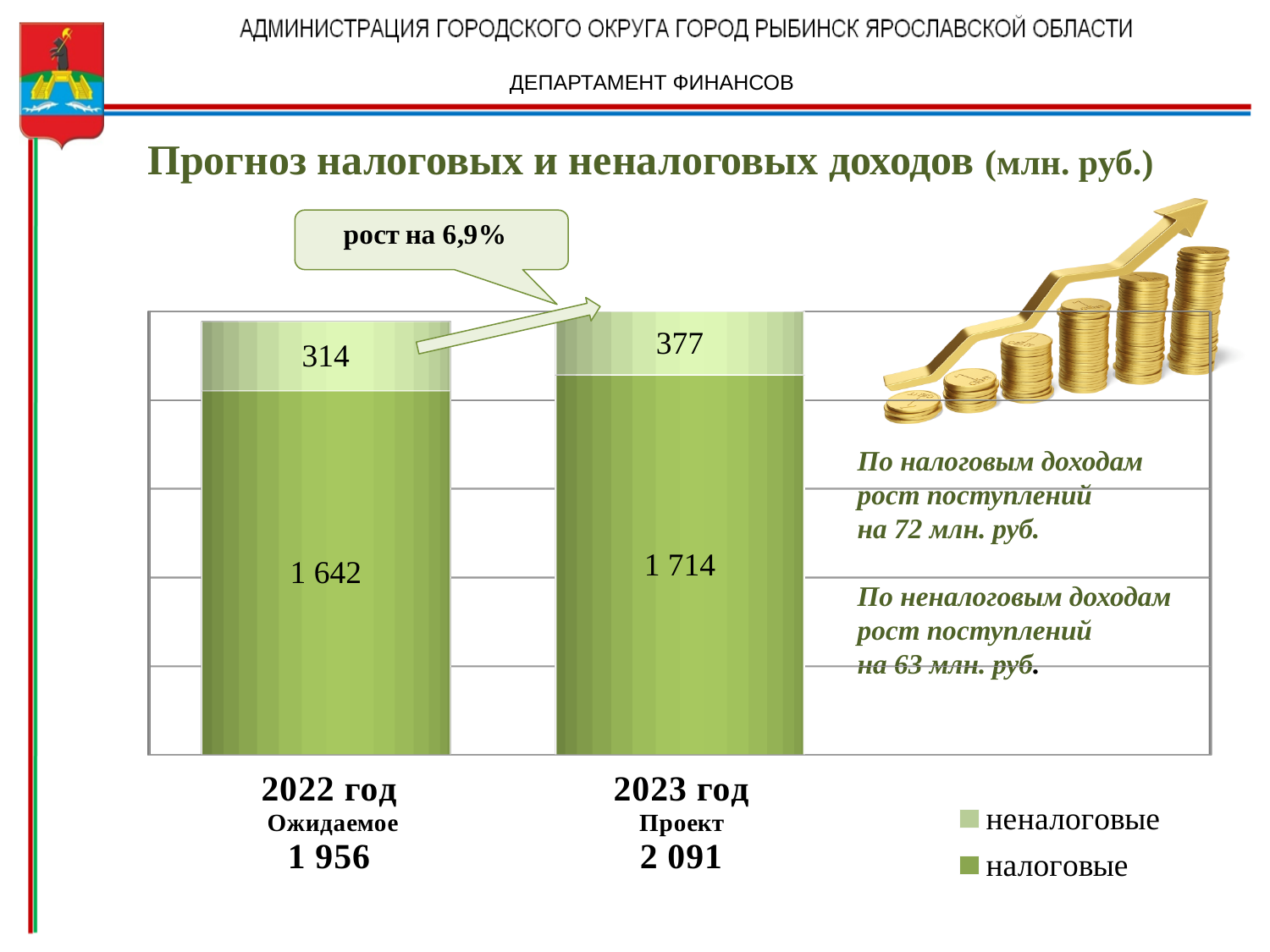
What is the difference between the неналоговые values for 2023 год and 2022 год? 63 How many series does the legend list? 2 What is the value of неналоговые for 2023 год? 377 Which year has the larger неналоговые value, 2022 год or 2023 год? 2023 год What is the total of the stacked bar for 2023 год? 2 091 What is the value of налоговые for 2023 год? 1 714 What is the value of налоговые for 2022 год? 1 642 What is the value of неналоговые for 2022 год? 314 What is the difference between the налоговые values for 2023 год and 2022 год? 72 What is the title of the chart? Прогноз налоговых и неналоговых доходов (млн. руб.) What is the total of the stacked bar for 2022 год? 1 956 What kind of chart is shown on the slide? Stacked bar chart